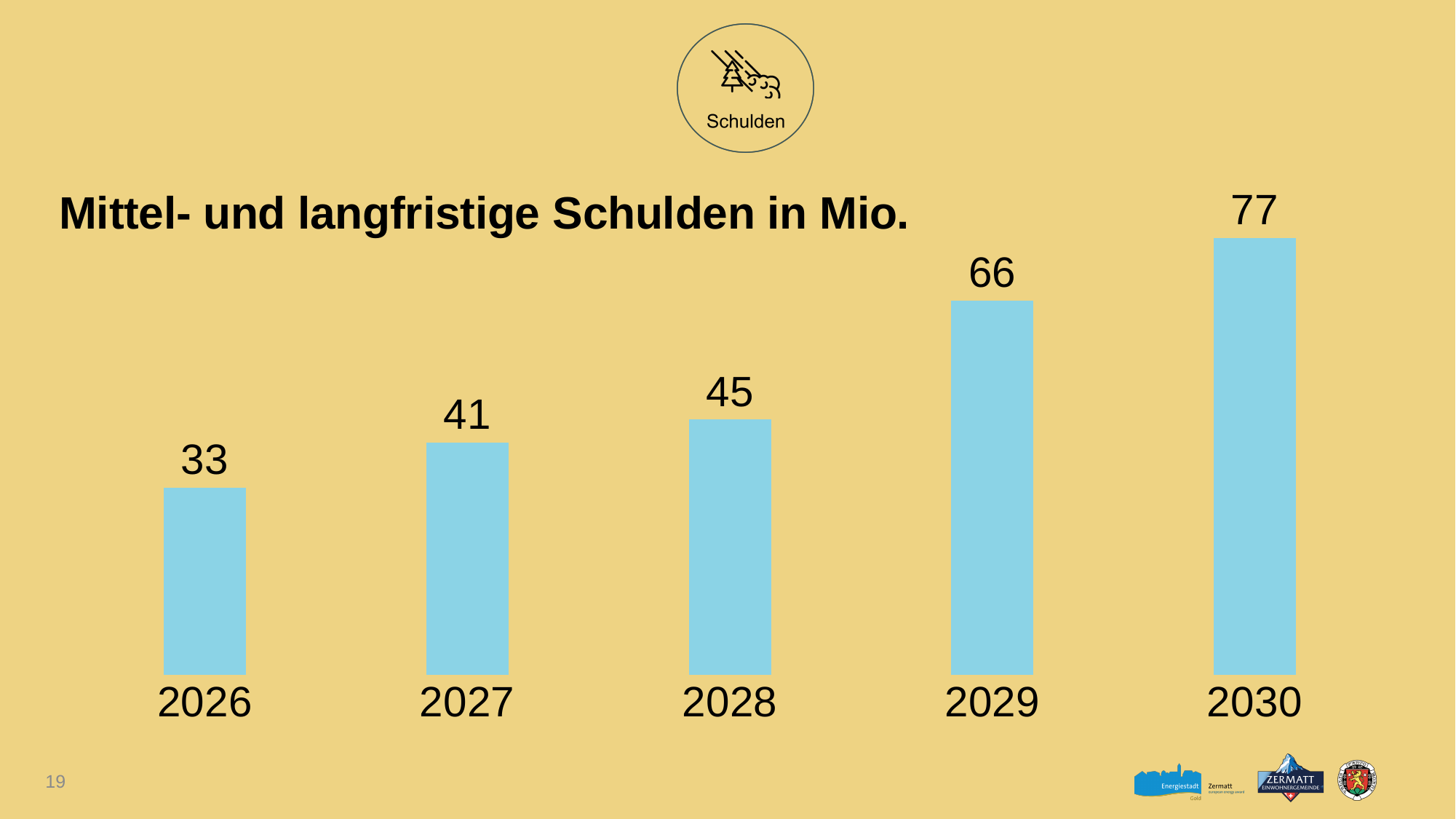
What is the title of the chart? Mittel- und langfristige Schulden in Mio. What is the difference between the values for 2030 and 2026? 44 What is the difference between the values for 2029 and 2028? 21 Which year has the lowest value? 2026 How many years are shown in the chart? 5 Do the values rise or fall from 2026 to 2030? rise What is the value for 2028? 45 Which year has the highest value? 2030 What is the value for 2026? 33 What is the value for 2030? 77 Which is larger, the value for 2027 or the value for 2029? 2029 What kind of chart is shown? bar chart